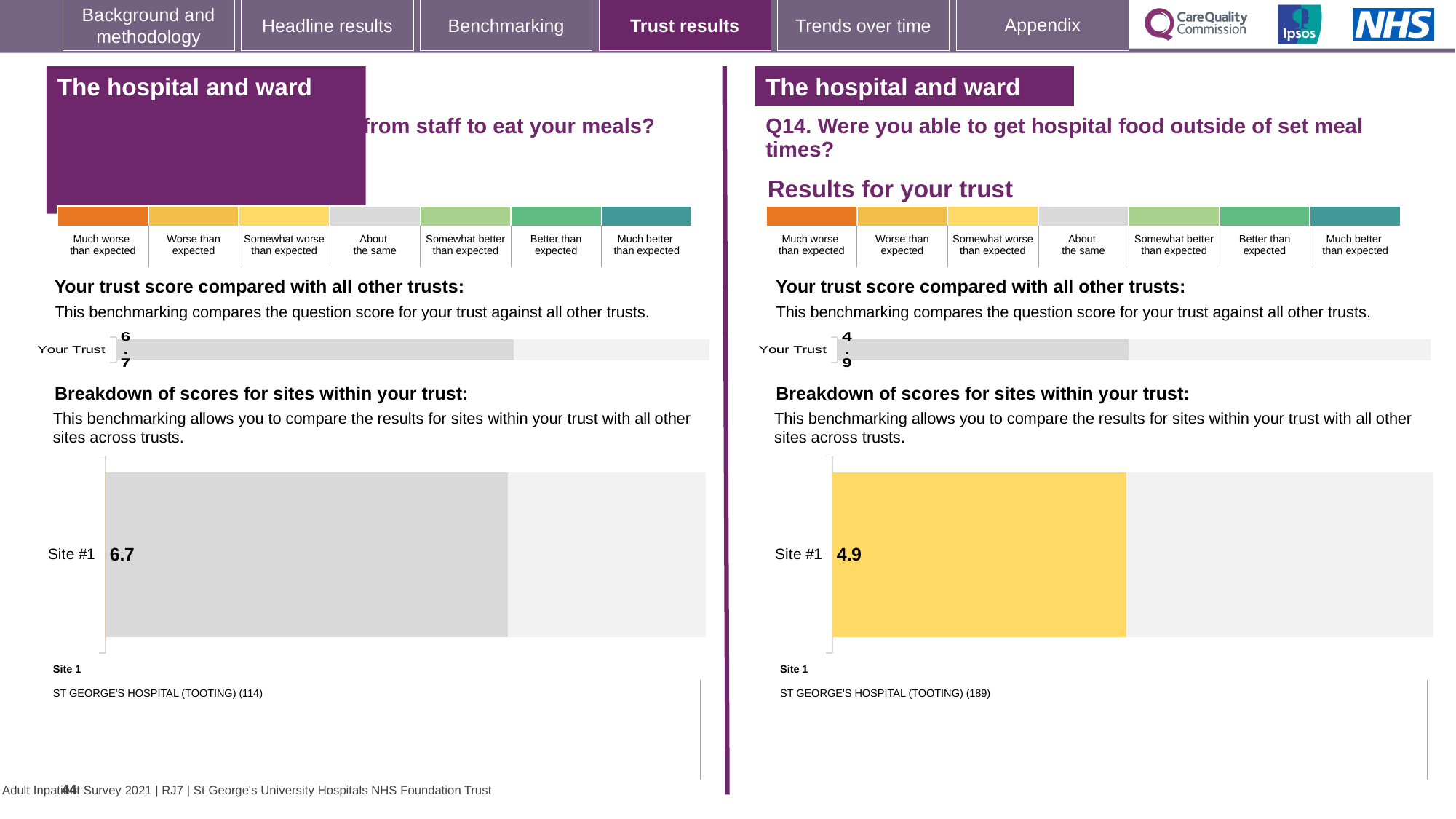
On the left-hand side of the slide, what is the 'Your Trust' score in the chart comparing the trust score with all other trusts? 6.7 What is the difference between the Site #1 score on the left-hand chart and the Site #1 score on the right-hand chart (Q14)? 1.8 Which site name is listed under 'Site 1' on the right-hand side of the slide (Q14)? ST GEORGE'S HOSPITAL (TOOTING) (189) What type of chart is used to show the breakdown of scores for sites within your trust on the right-hand side (Q14)? Bar chart On the right-hand side of the slide (Q14), what is the 'Your Trust' score in the chart comparing the trust score with all other trusts? 4.9 How many sites are shown in the breakdown of scores for sites within your trust on the left-hand side of the slide? 1 On the right-hand side (Q14), what colour is the Site #1 bar in the breakdown of scores chart? Yellow On the left-hand side of the slide, what is the score shown for Site #1 in the breakdown of scores for sites within your trust? 6.7 On the left-hand side, what colour is the Site #1 bar in the breakdown of scores chart? Grey On the right-hand side of the slide (Q14), what is the score shown for Site #1 in the breakdown of scores for sites within your trust? 4.9 How many sites are shown in the breakdown of scores for sites within your trust on the right-hand side (Q14)? 1 Which Site #1 score is larger: the one on the left-hand chart or the one on the right-hand chart (Q14)? The left-hand chart (6.7)